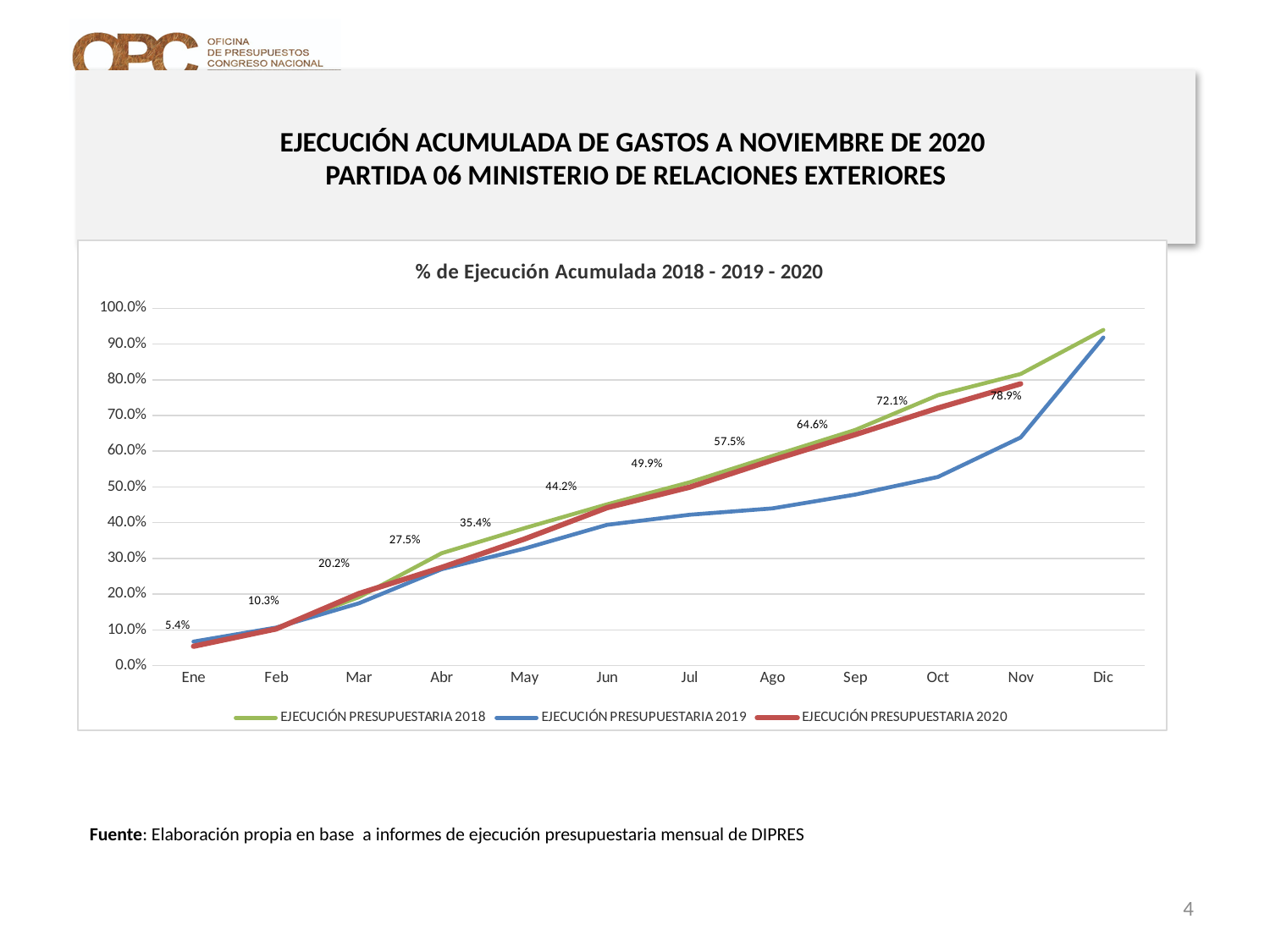
What is the title of the chart? % de Ejecución Acumulada 2018 - 2019 - 2020 Does the EJECUCIÓN PRESUPUESTARIA 2020 series rise or fall from Ene to Nov? rise Is the value for EJECUCIÓN PRESUPUESTARIA 2019 in Oct greater or less than 60.0%? less What is the difference between the EJECUCIÓN PRESUPUESTARIA 2020 values for Nov and Oct? 6.8% What is the difference between the EJECUCIÓN PRESUPUESTARIA 2020 values for Sep and Ago? 7.1% What is the value for EJECUCIÓN PRESUPUESTARIA 2020 in Jun? 44.2% What is the value for EJECUCIÓN PRESUPUESTARIA 2020 in Nov? 78.9% What type of chart is shown on the slide? line chart What is the value for EJECUCIÓN PRESUPUESTARIA 2020 in Ene? 5.4% Which series has the higher value in Dic, EJECUCIÓN PRESUPUESTARIA 2018 or EJECUCIÓN PRESUPUESTARIA 2019? EJECUCIÓN PRESUPUESTARIA 2018 How many months are shown on the x axis? 12 How many series does the legend list? 3